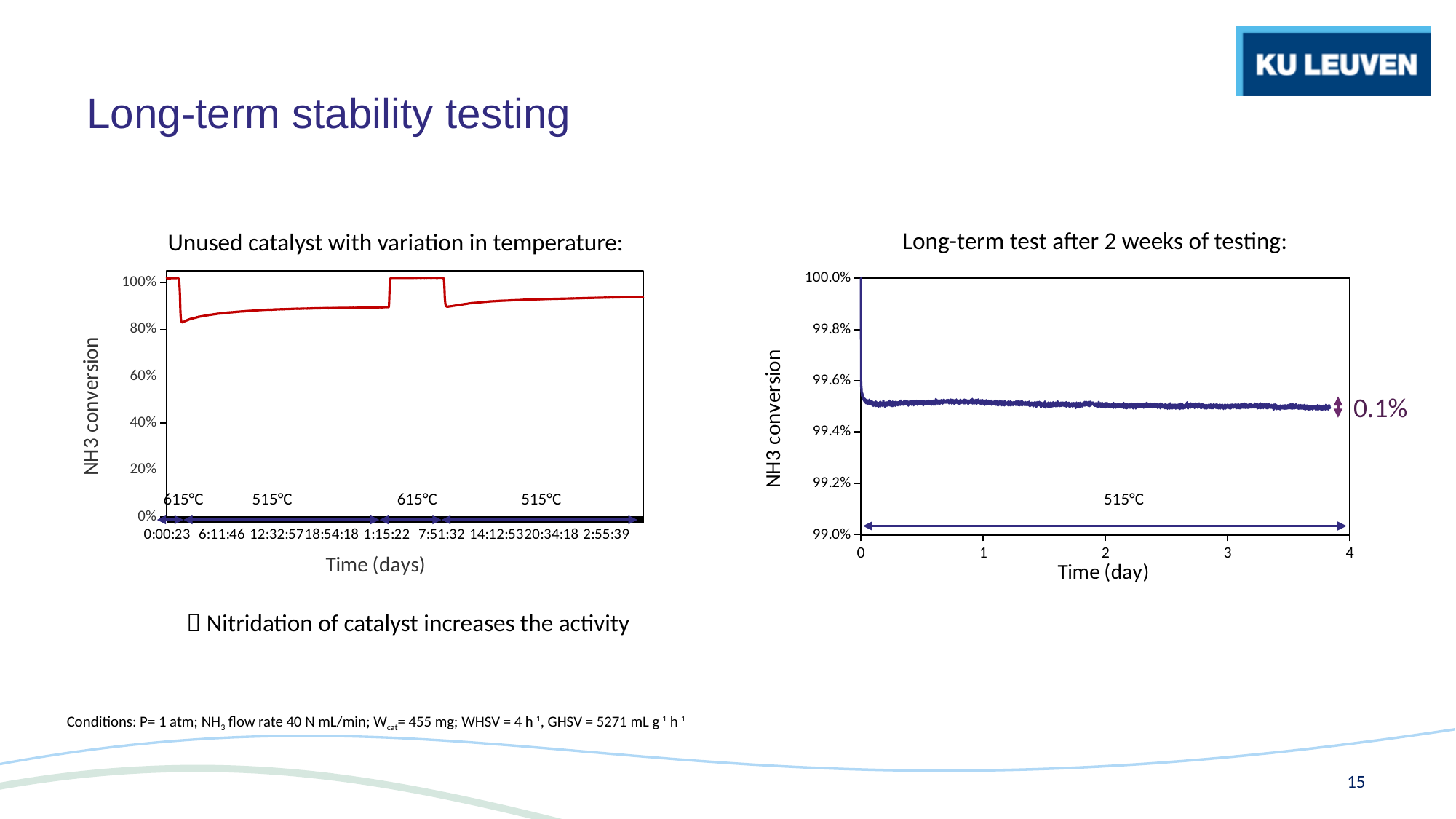
In the left chart, is the NH3 conversion during the first 515°C period greater or less than 60%? greater In the right chart, is the NH3 conversion at day 2 greater or less than 99.6%? less In the right chart, what is the x-axis title? Time (day) In the left chart, does the NH3 conversion rise or fall over the course of the final 515°C period? rise In the right chart, what is the largest value shown on the x-axis? 4 In the left chart, what is the y-axis title? NH3 conversion What kind of chart is the 'Unused catalyst with variation in temperature' chart on the left? line chart In the left chart, is the NH3 conversion during the second 615°C period greater or less than 80%? greater In the left chart, how many temperature labels are shown along the bottom of the plot? 4 In the right chart, what is the highest value shown on the y-axis? 100.0% What kind of chart is the 'Long-term test after 2 weeks of testing' chart on the right? line chart